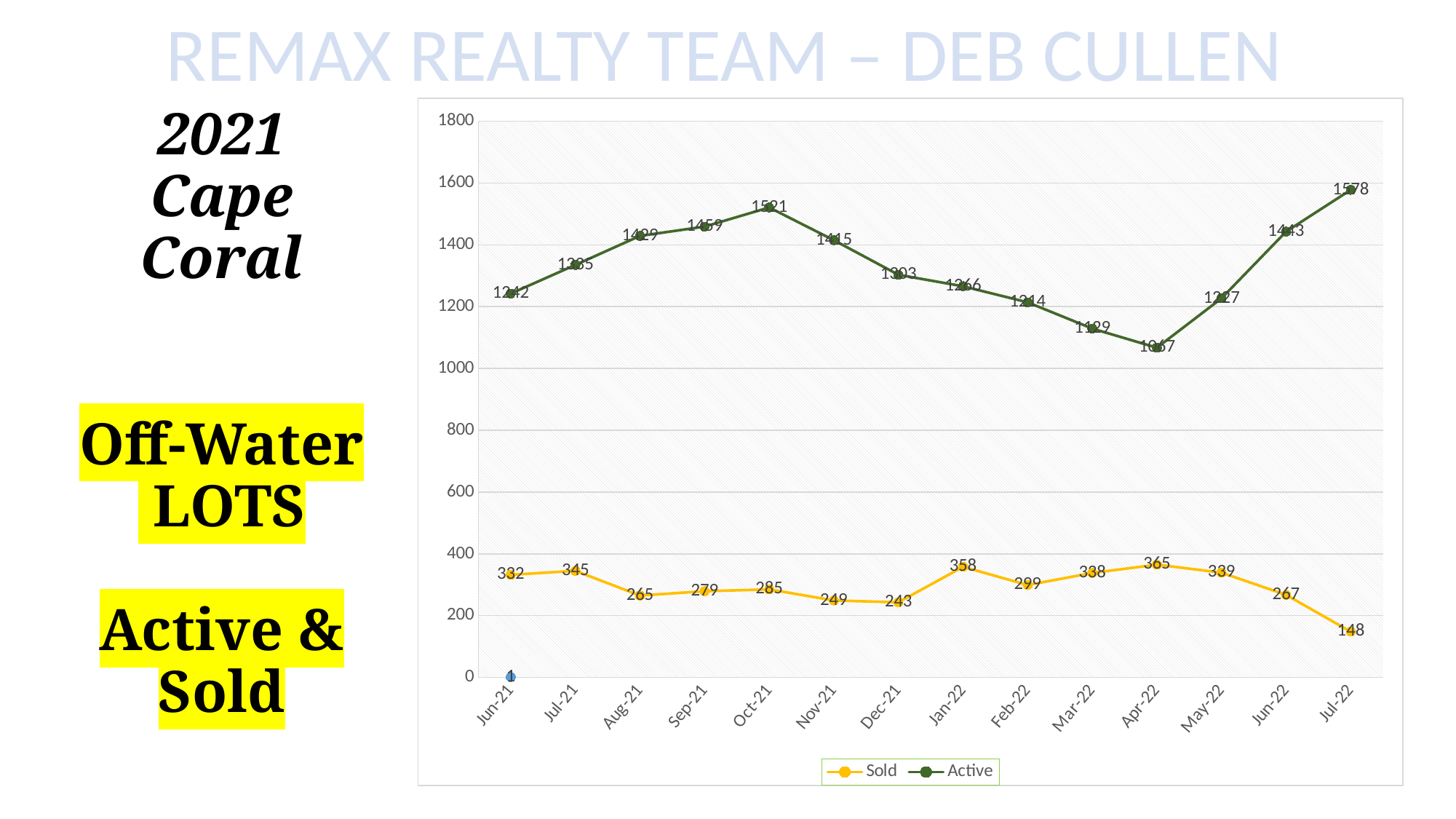
How many months are plotted along the x axis? 14 In which month is the Sold series lowest? Jul-22 Is the Active value for Apr-22 greater or less than 1200? less In which month is the Active series lowest? Apr-22 What kind of chart is shown on the slide? line chart What is the difference between the Sold values for Jan-22 and Dec-21? 115 What is the Active value for Jul-22? 1578 What is the Sold value for Apr-22? 365 In which month is the Sold series highest? Apr-22 How many series does the legend list? 2 What is the Sold value for Jul-22? 148 What is the Active value for Oct-21? 1521